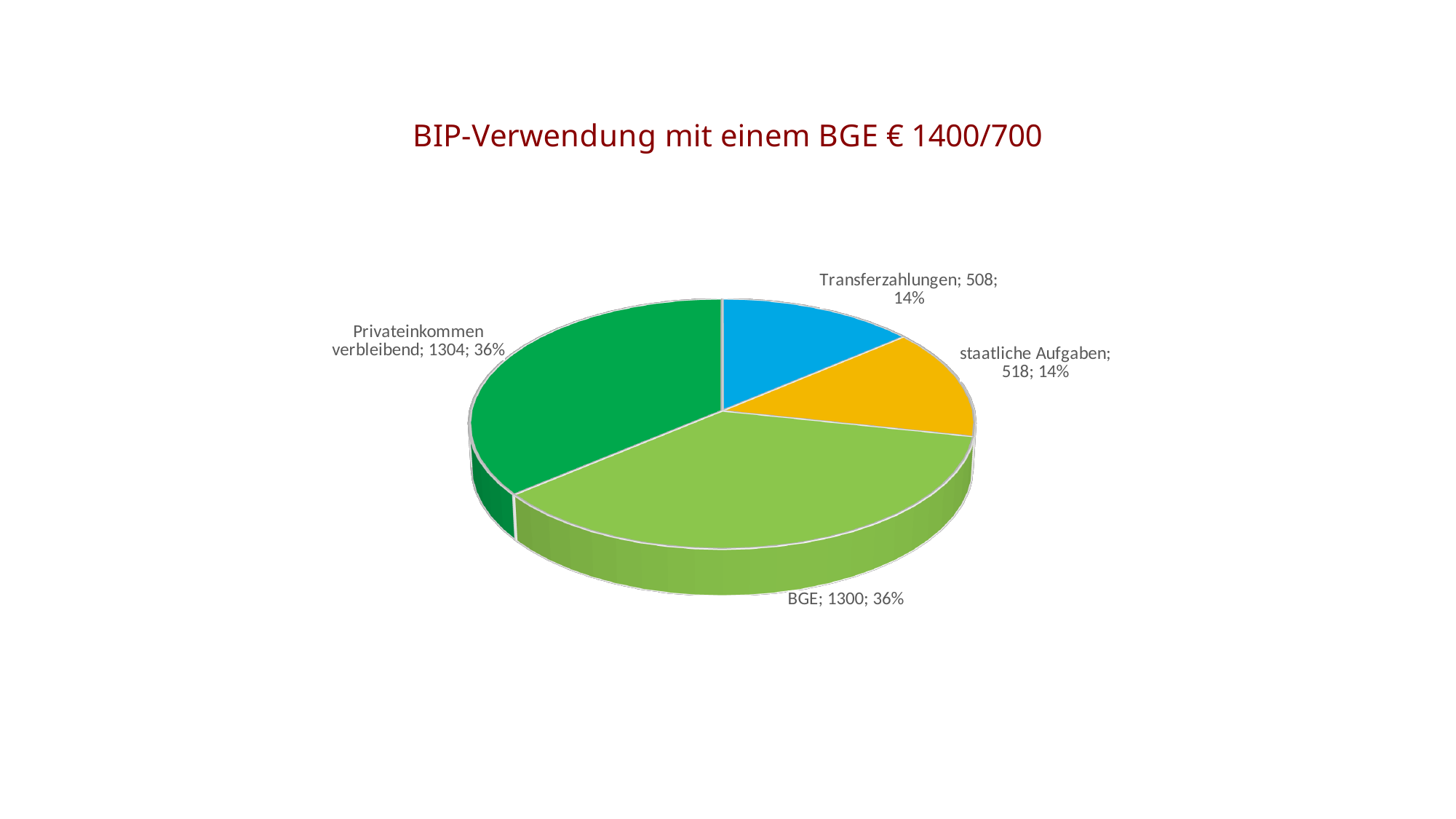
What share of the pie does the BGE slice represent? 36% What is the difference between the values for Privateinkommen verbleibend and Transferzahlungen? 796 Which is larger, the value for BGE or the value for staatliche Aufgaben? BGE What value is shown for the Transferzahlungen slice? 508 What is the title of the chart? BIP-Verwendung mit einem BGE € 1400/700 What share of the pie does the Transferzahlungen slice represent? 14% How many slices does the pie chart have? 4 What value is shown for the BGE slice? 1300 What value is shown for the staatliche Aufgaben slice? 518 What value is shown for the Privateinkommen verbleibend slice? 1304 What kind of chart is shown on the slide? pie chart What is the difference between the values for staatliche Aufgaben and Transferzahlungen? 10